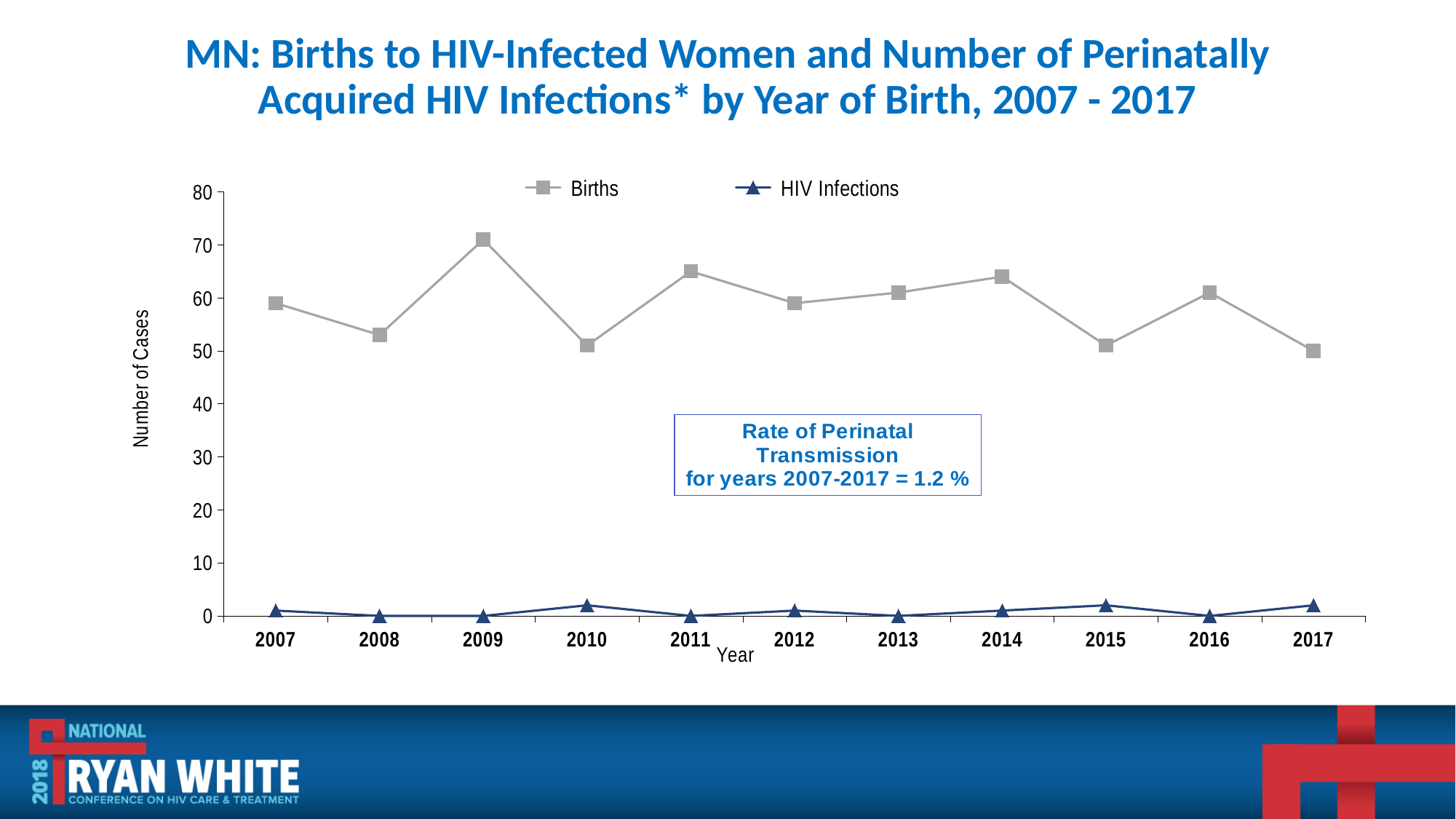
Is the value for Births in 2009 greater or less than 60? greater How many years are plotted along the x axis? 11 What kind of chart is shown on the slide? line chart Did the number of Births rise or fall from 2007 to 2008? fall How many series does the legend list? 2 What rate of perinatal transmission for 2007-2017 is stated in the box on the chart? 1.2 % In which year was the number of Births highest? 2009 Is the value for Births in 2011 greater or less than 60? greater Is the value for Births in 2008 greater or less than 60? less Which is larger, the number of Births in 2009 or in 2010? 2009 What are the two series named in the legend? Births and HIV Infections